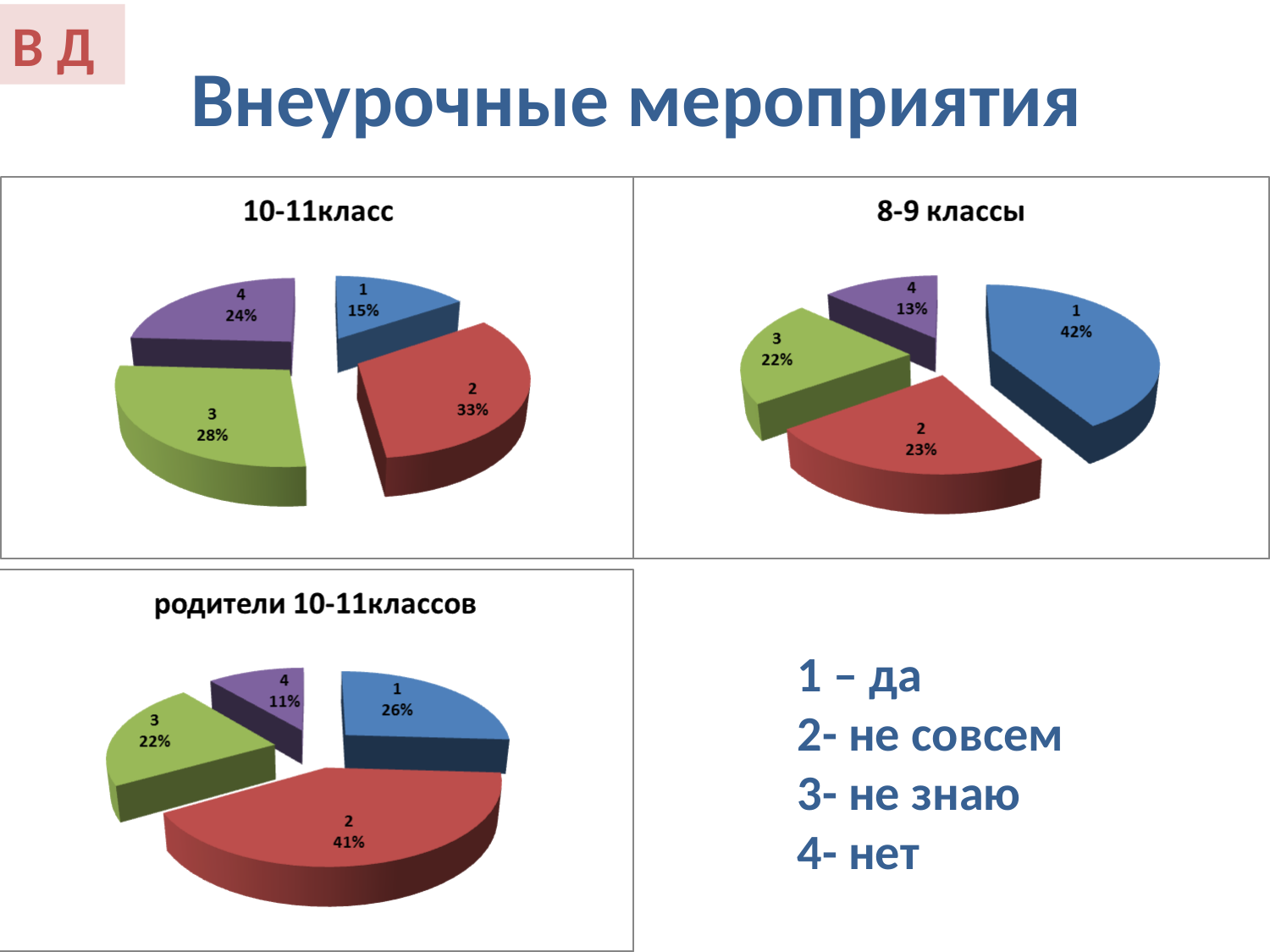
In the "родители 10-11классов" chart, what is the difference between slice 1 and slice 3? 4% In the "родители 10-11классов" chart, which slice has the largest share? 2 According to the key on the slide, what does answer 3 stand for? не знаю In the "10-11класс" chart, what percentage is shown for slice 2? 33% In the "8-9 классы" chart, which slice has the smallest share? 4 In the "8-9 классы" chart, what percentage is shown for slice 1? 42% In the "родители 10-11классов" chart, what percentage is shown for slice 4? 11% What type of chart is used for "8-9 классы"? Pie chart In the "10-11класс" chart, which slice has the largest share? 2 In the "8-9 классы" chart, which is larger: slice 2 or slice 3? 2 In the "10-11класс" chart, what is the difference between the shares of slice 2 and slice 1? 18% How many slices does the "родители 10-11классов" chart have? 4